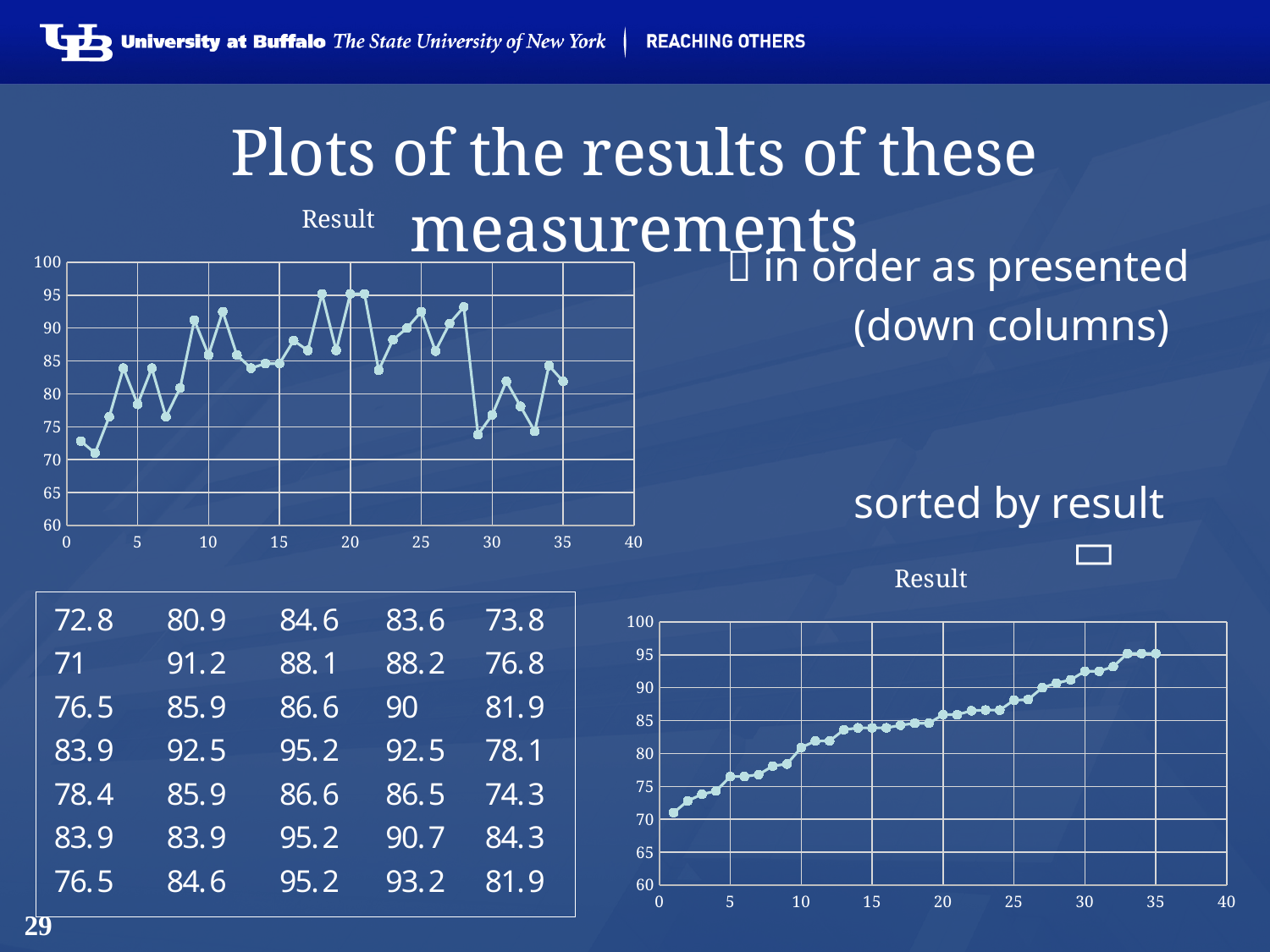
What is the highest value shown on the y axis of the bottom-right chart? 100 How many data points are plotted in the top-left chart (in order as presented)? 35 In the top-left chart (in order as presented), is the value at x = 2 greater or less than 75? less In the top-left chart (in order as presented), which is larger: the value at x = 2 or the value at x = 20? x = 20 What kind of chart is the top-left chart titled "Result"? line chart What is the title shown above each of the two charts? Result In the bottom-right chart (sorted by result), is the value at x = 1 greater or less than 75? less In the bottom-right chart (sorted by result), is the value at x = 35 greater or less than 90? greater What kind of chart is the bottom-right chart titled "Result"? line chart How many data points are plotted in the bottom-right chart (sorted by result)? 35 In the bottom-right chart (sorted by result), do the values rise or fall along the x axis? rise